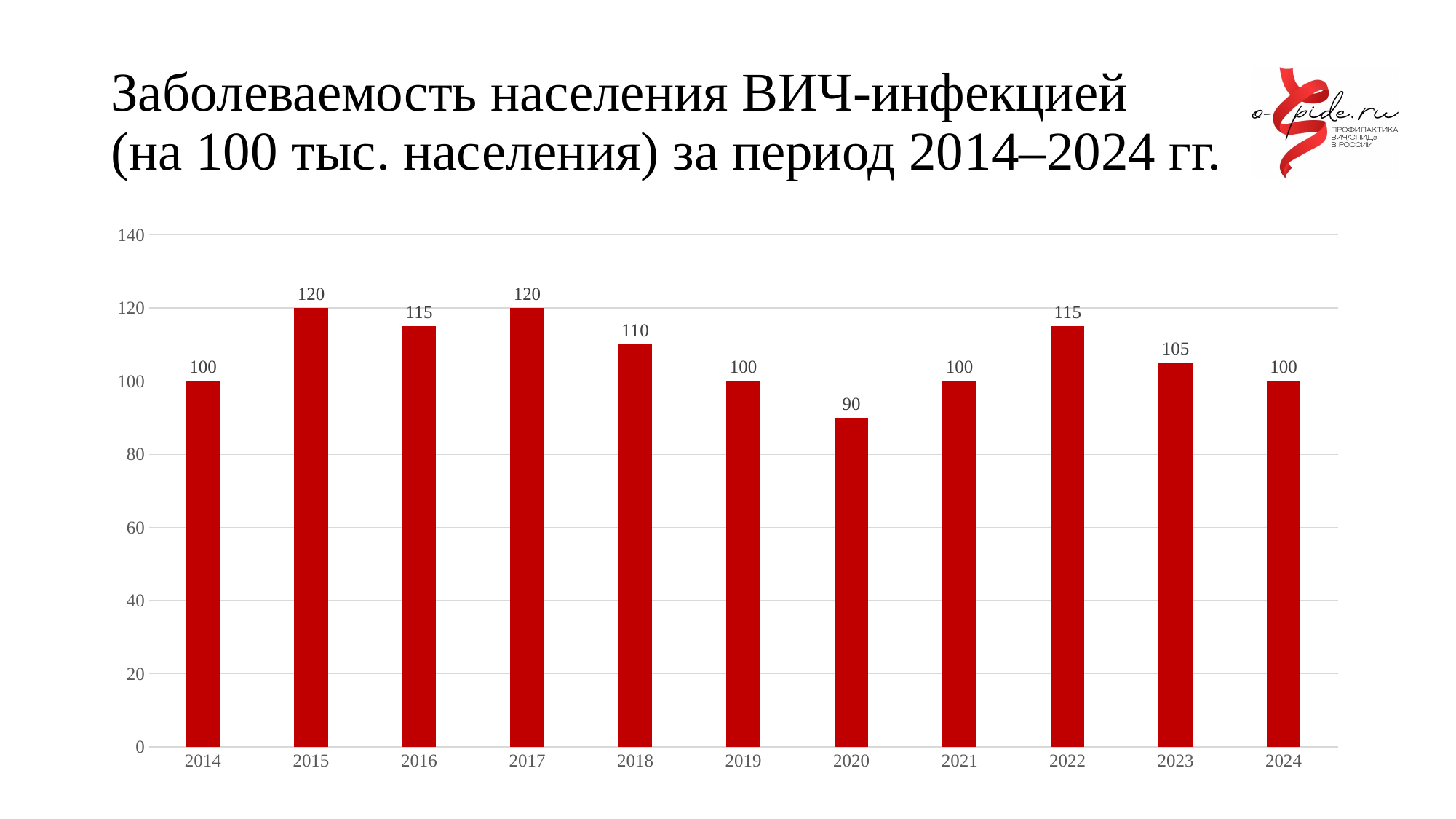
What is the value for 2018? 110 What is the value for 2023? 105 Is the value for 2017 greater or less than 100? greater Which is larger, the value for 2016 or the value for 2019? 2016 What is the difference between the values for 2015 and 2020? 30 Do the values rise or fall from 2017 to 2020? fall What is the value for 2020? 90 What kind of chart is shown on the slide? bar chart What is the value for 2022? 115 Which year has the lowest value? 2020 How many years are shown on the x axis? 11 What is the difference between the values for 2022 and 2023? 10